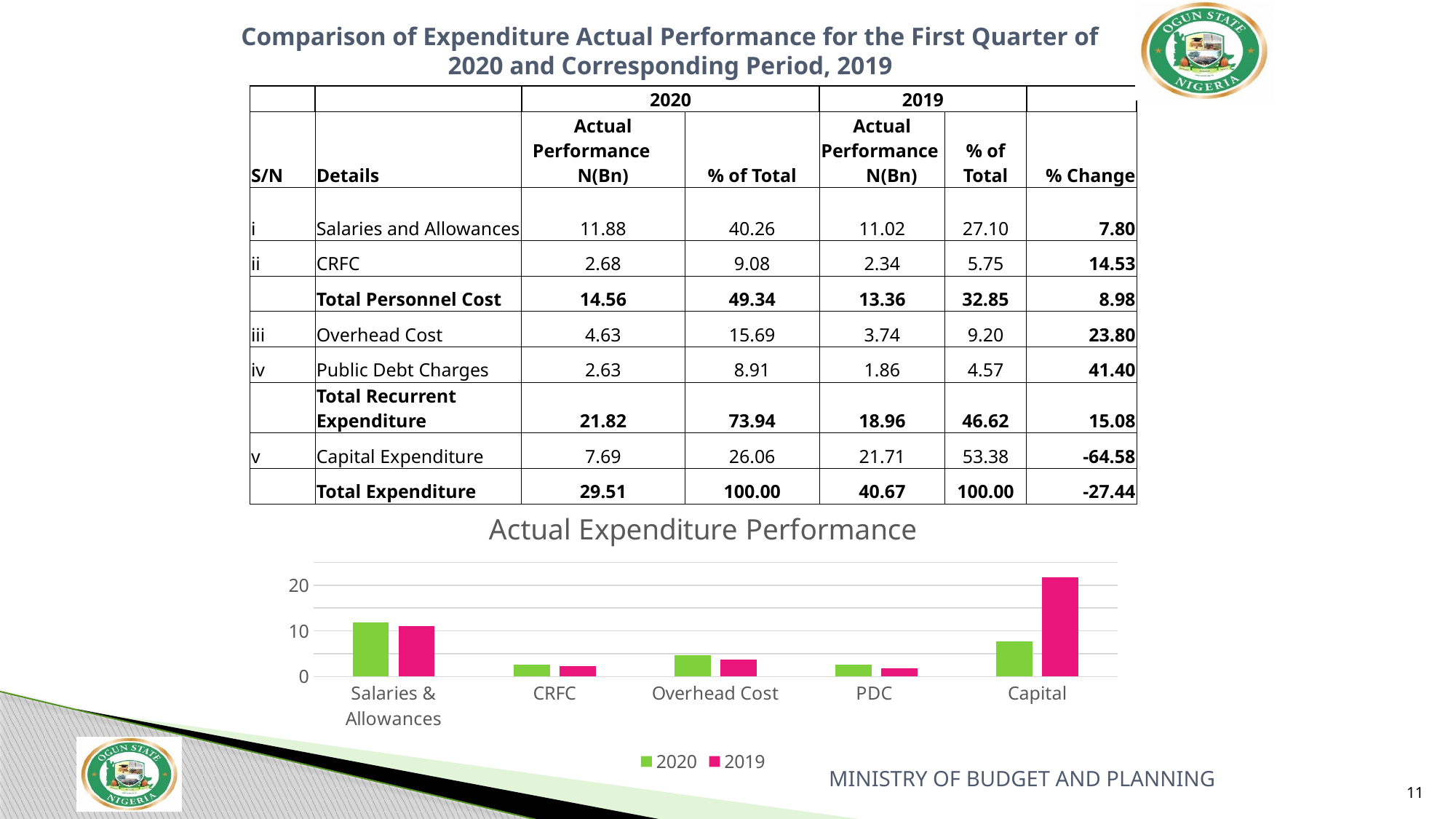
What kind of chart is shown under the title "Actual Expenditure Performance"? Bar chart In the "Actual Expenditure Performance" chart, is the 2020 value for Overhead Cost greater or less than 10? less How many categories are shown on the x axis of the "Actual Expenditure Performance" chart? 5 In the "Actual Expenditure Performance" chart, for Capital, which is larger: the 2020 value or the 2019 value? 2019 In the "Actual Expenditure Performance" chart, is the 2020 value for Salaries & Allowances greater or less than 10? greater In the "Actual Expenditure Performance" chart, which category has the highest 2019 value? Capital Which series are listed in the legend of the "Actual Expenditure Performance" chart? 2020 and 2019 In the "Actual Expenditure Performance" chart, which category has the highest 2020 value? Salaries & Allowances How many series does the legend of the "Actual Expenditure Performance" chart list? 2 In the "Actual Expenditure Performance" chart, which category has the tallest bar overall? Capital In the "Actual Expenditure Performance" chart, is the 2019 value for Capital greater or less than 10? greater In the "Actual Expenditure Performance" chart, what colour represents the 2020 series? Green